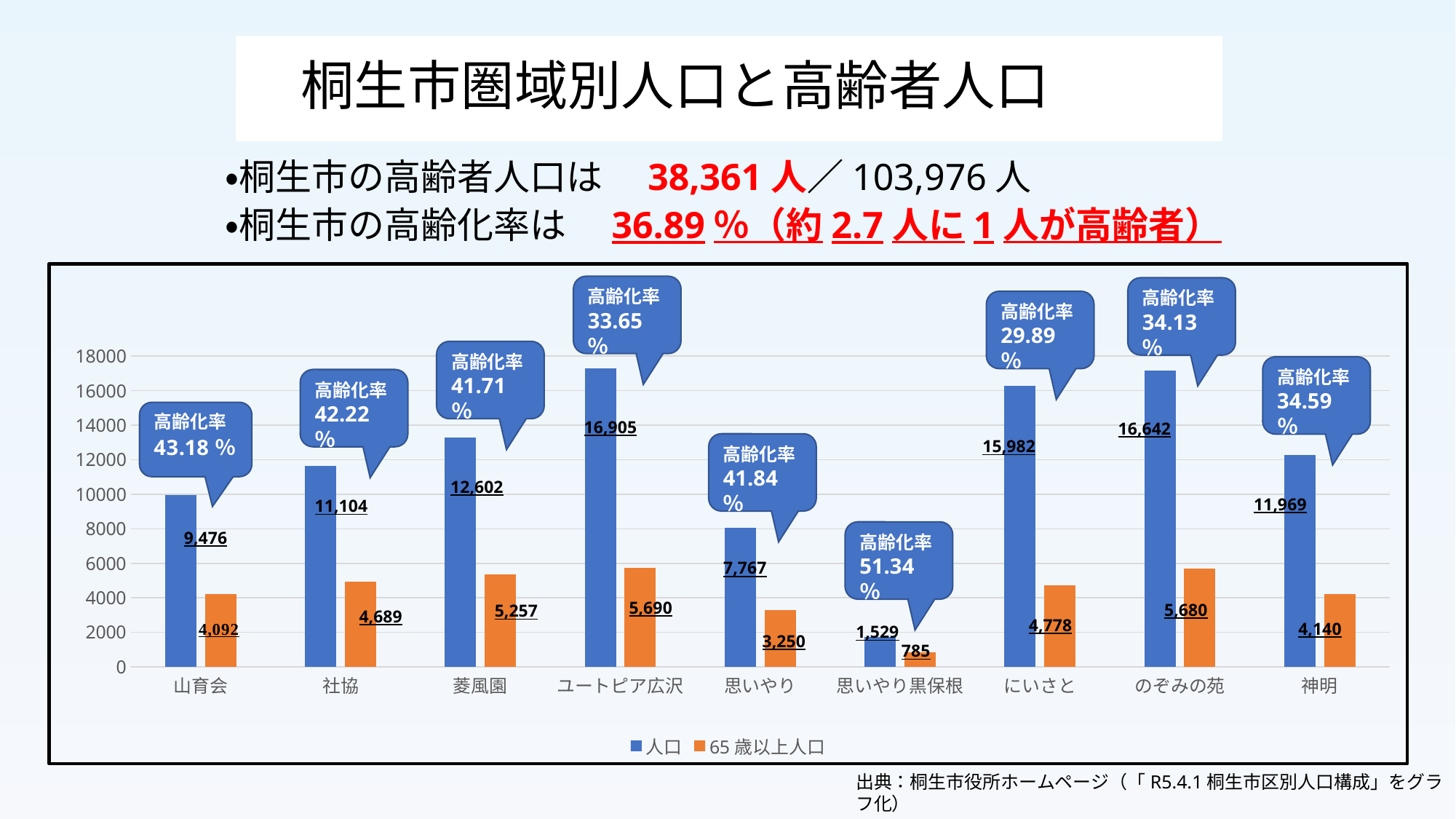
How many series does the legend list? 2 What is the 人口 value for ユートピア広沢? 16,905 What is the difference between the 人口 value and the 65歳以上人口 value for 山育会? 5,384 Which is larger, the 65歳以上人口 value for 菱風園 or for にいさと? 菱風園 Is the 人口 value for 神明 greater or less than 10000? greater What 高齢化率 is shown in the callout for 思いやり黒保根? 51.34% What colour are the bars for the 65歳以上人口 series? orange Which category has the highest 人口 value? ユートピア広沢 What kind of chart is shown on the slide? bar chart Which category has the lowest 65歳以上人口 value? 思いやり黒保根 What is the 65歳以上人口 value for 思いやり黒保根? 785 How many categories are shown on the x axis? 9